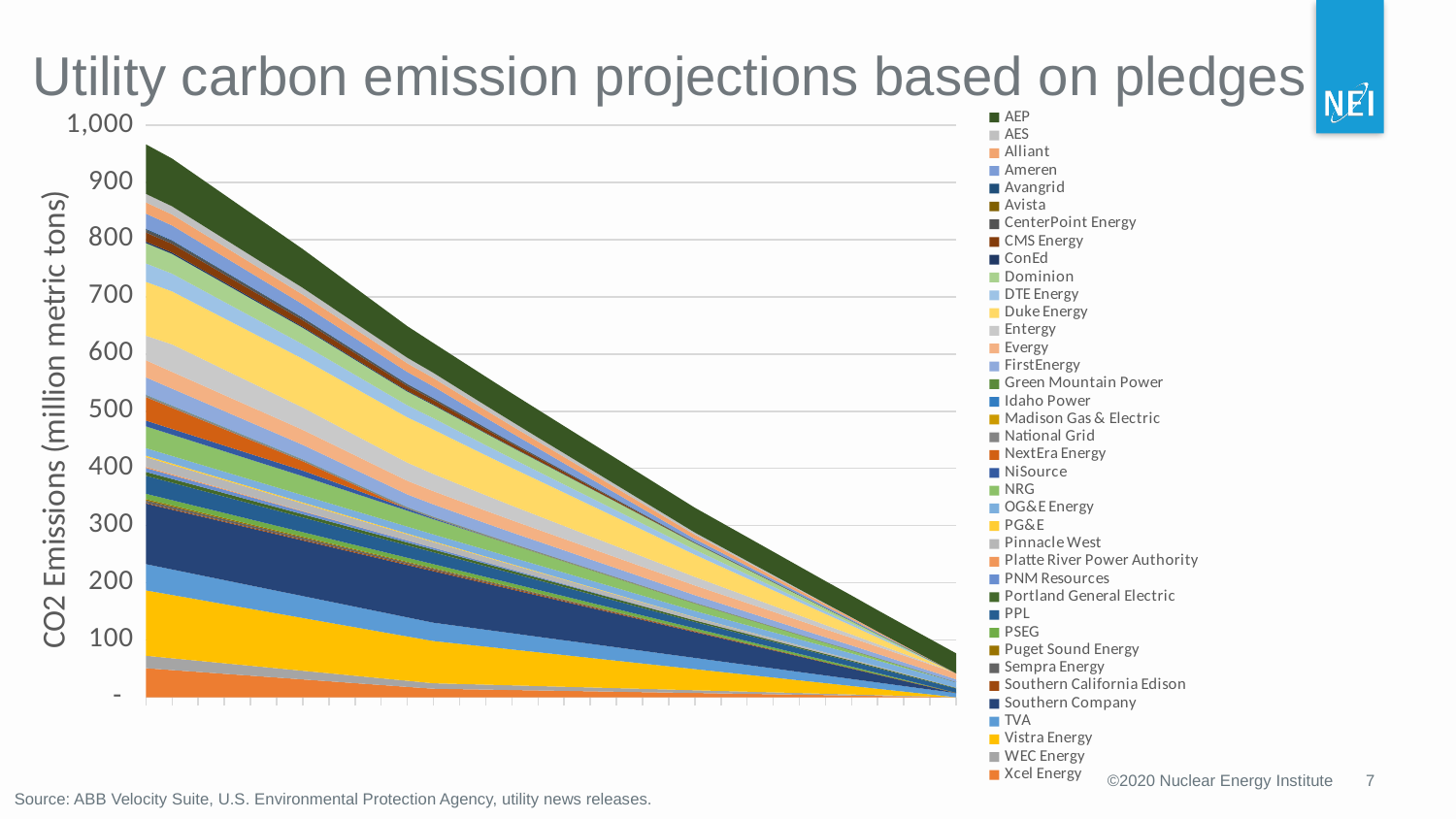
How many series does the legend list? 38 Is the total stacked value at the left edge of the chart greater or less than 900? greater What is the label on the y axis? CO2 Emissions (million metric tons) Do the total projected CO2 emissions rise or fall along the x axis? Fall Is the total stacked value at the right edge of the chart greater or less than 500? less Is the total stacked value at the right edge of the chart greater or less than 100? less What kind of chart is shown on the slide? Stacked area chart What is the title of the chart? Utility carbon emission projections based on pledges